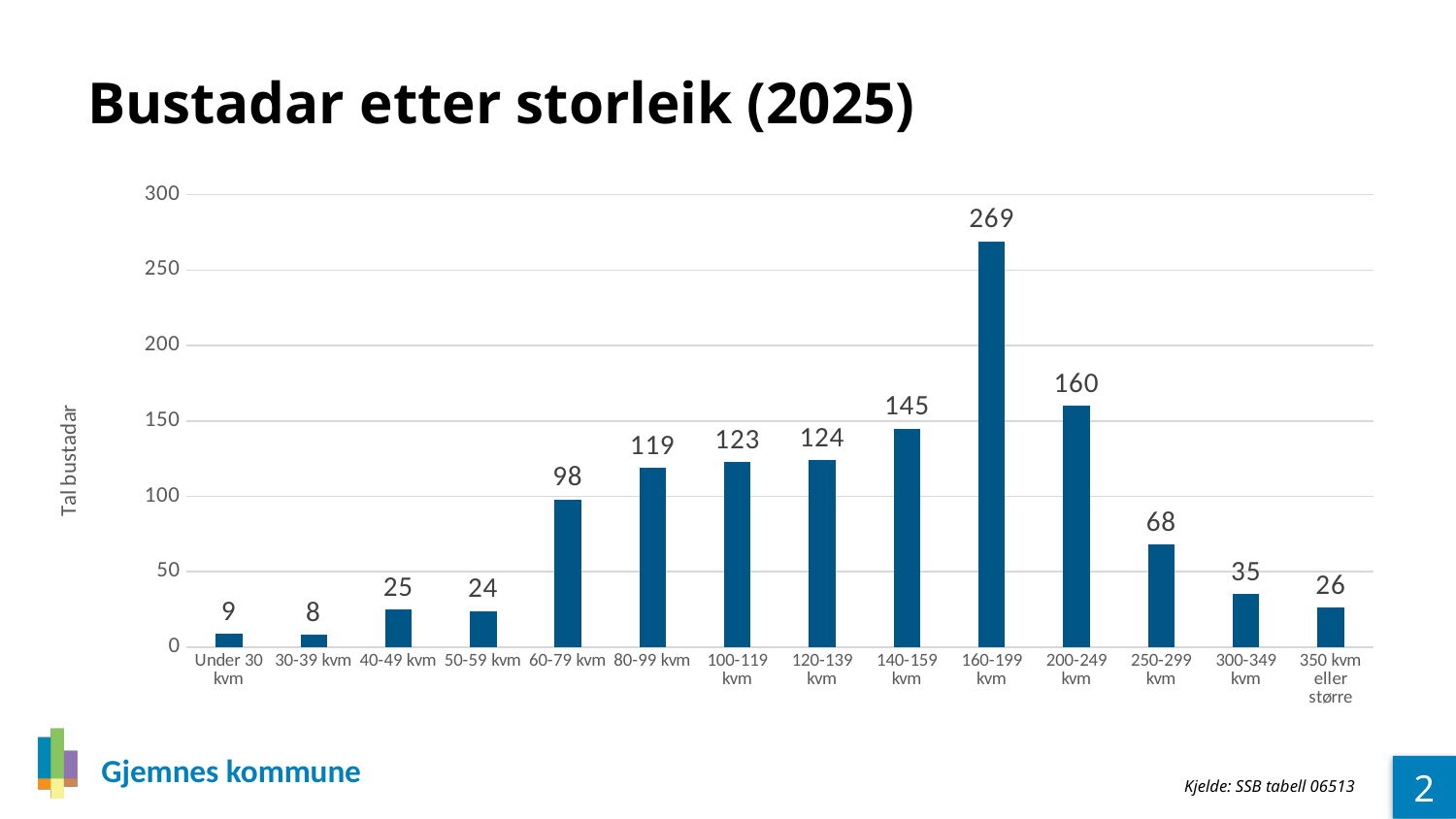
What is the value for 350 kvm eller større? 26 What is the value for 160-199 kvm? 269 What is the difference between the values for 160-199 kvm and 200-249 kvm? 109 Which category has the highest value? 160-199 kvm How many categories are shown on the x axis? 14 Which category has the lowest value? 30-39 kvm What is the label on the vertical axis? Tal bustadar What is the title of the chart? Bustadar etter storleik (2025) Which is larger, the value for 140-159 kvm or the value for 250-299 kvm? 140-159 kvm What is the value for 60-79 kvm? 98 Is the value for 200-249 kvm greater or less than 150? greater What kind of chart is shown on the slide? bar chart